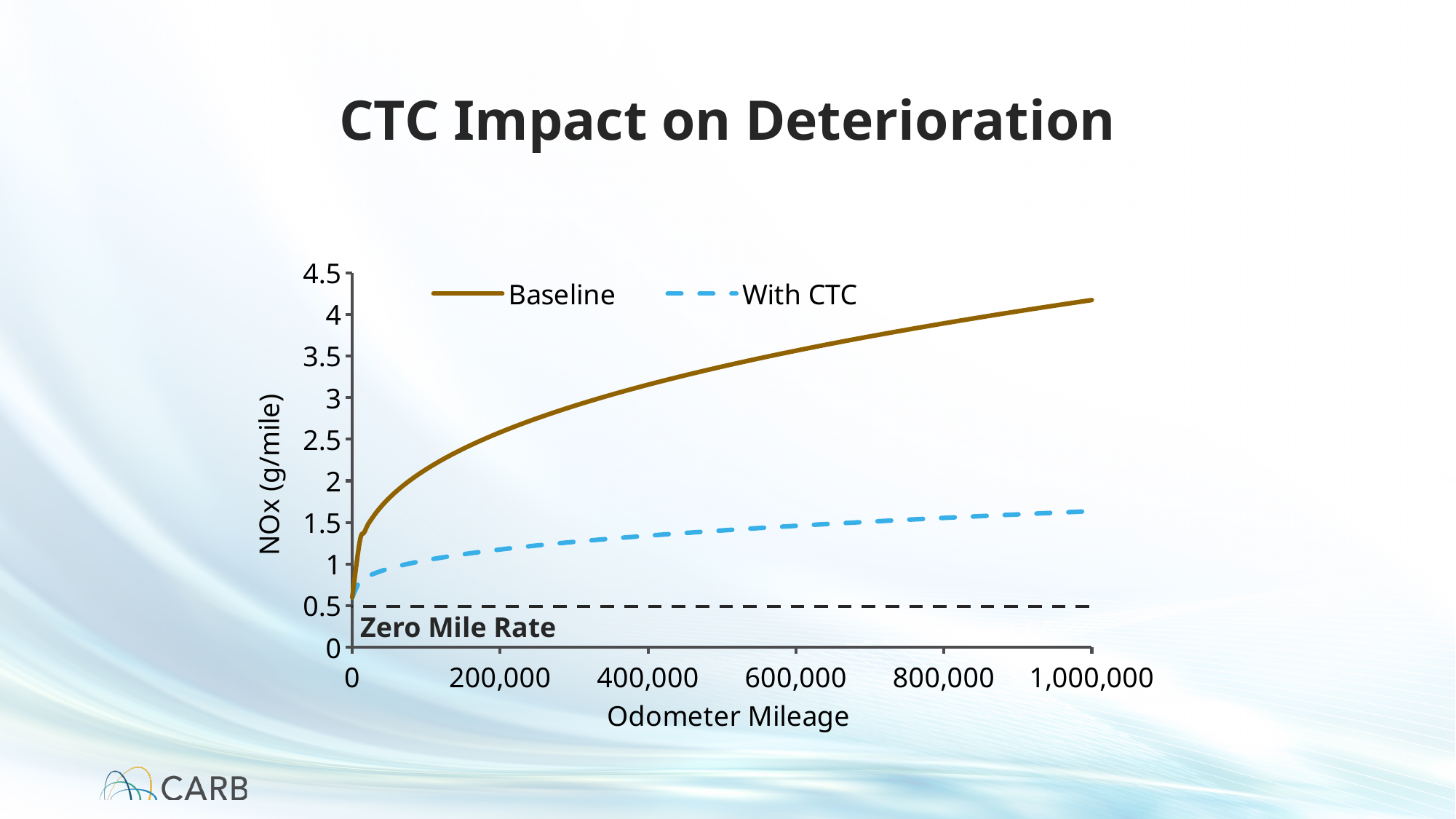
What are the two series named in the legend? Baseline and With CTC Is the With CTC value at 1,000,000 miles greater or less than 2? less How many series does the legend list? 2 What is the title of the chart? CTC Impact on Deterioration Is the Baseline value at 1,000,000 miles greater or less than 4? greater Does the With CTC series rise or fall as odometer mileage increases? rise Is the With CTC value at 400,000 miles greater or less than 1.5? less At 1,000,000 miles, which series has the higher NOx value, Baseline or With CTC? Baseline Does the Baseline series rise or fall as odometer mileage increases? rise What kind of chart is shown on the slide? line chart